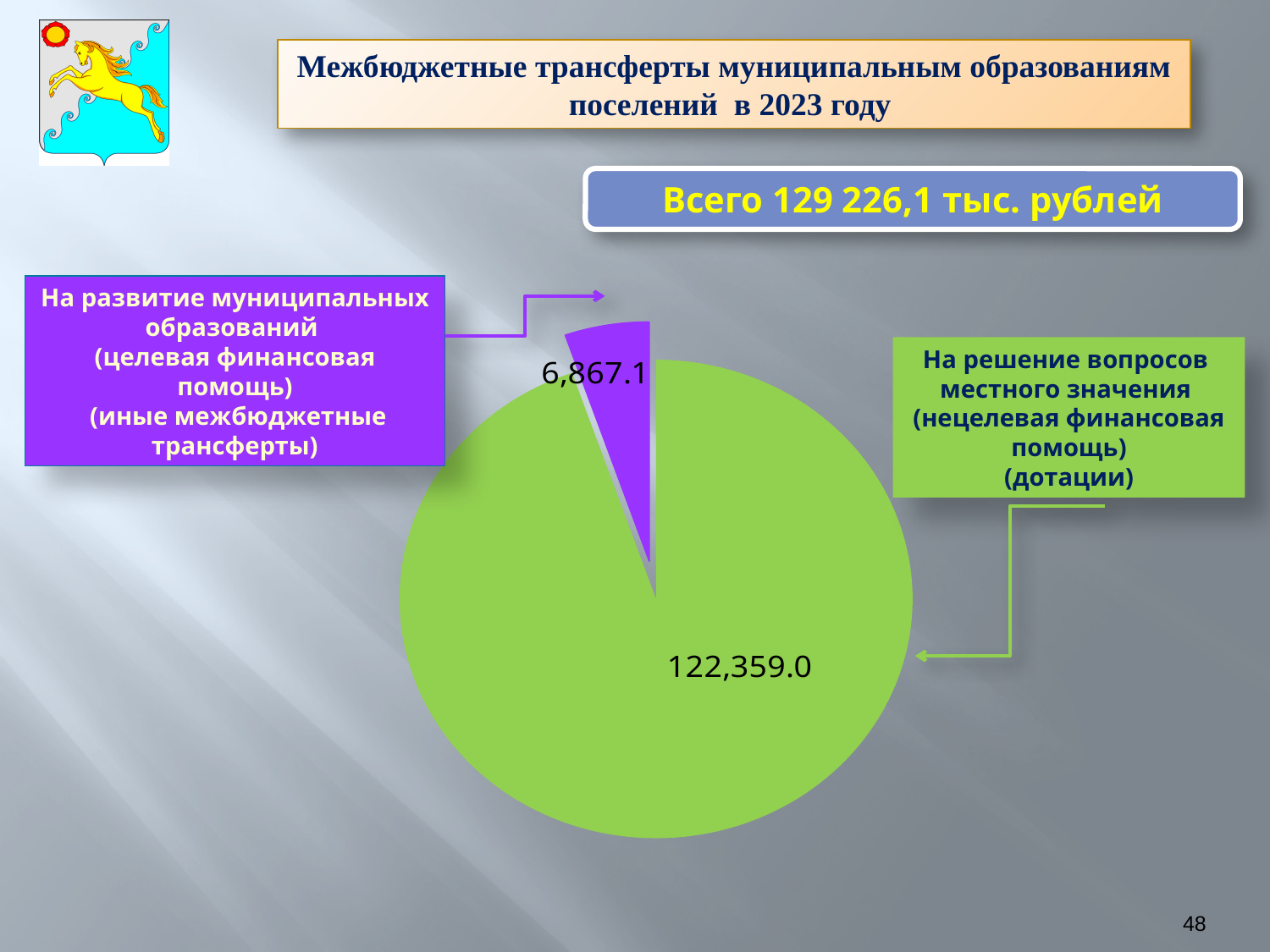
What colour is the slice representing дотации (нецелевая финансовая помощь)? green Which category has the smallest slice of the pie? На развитие муниципальных образований (иные межбюджетные трансферты) What is the value of the green slice (дотации, на решение вопросов местного значения)? 122,359.0 What year does the chart title refer to? 2023 How many slices does the pie chart have? 2 What kind of chart is shown on the slide? pie chart Which category has the largest slice of the pie? На решение вопросов местного значения (дотации) What total amount of intergovernmental transfers is stated on the slide? 129 226,1 тыс. рублей What is the difference between the green slice value and the purple slice value? 115,491.9 Which is larger: the value for дотации or the value for иные межбюджетные трансферты? дотации What is the value of the purple slice (иные межбюджетные трансферты, на развитие муниципальных образований)? 6,867.1